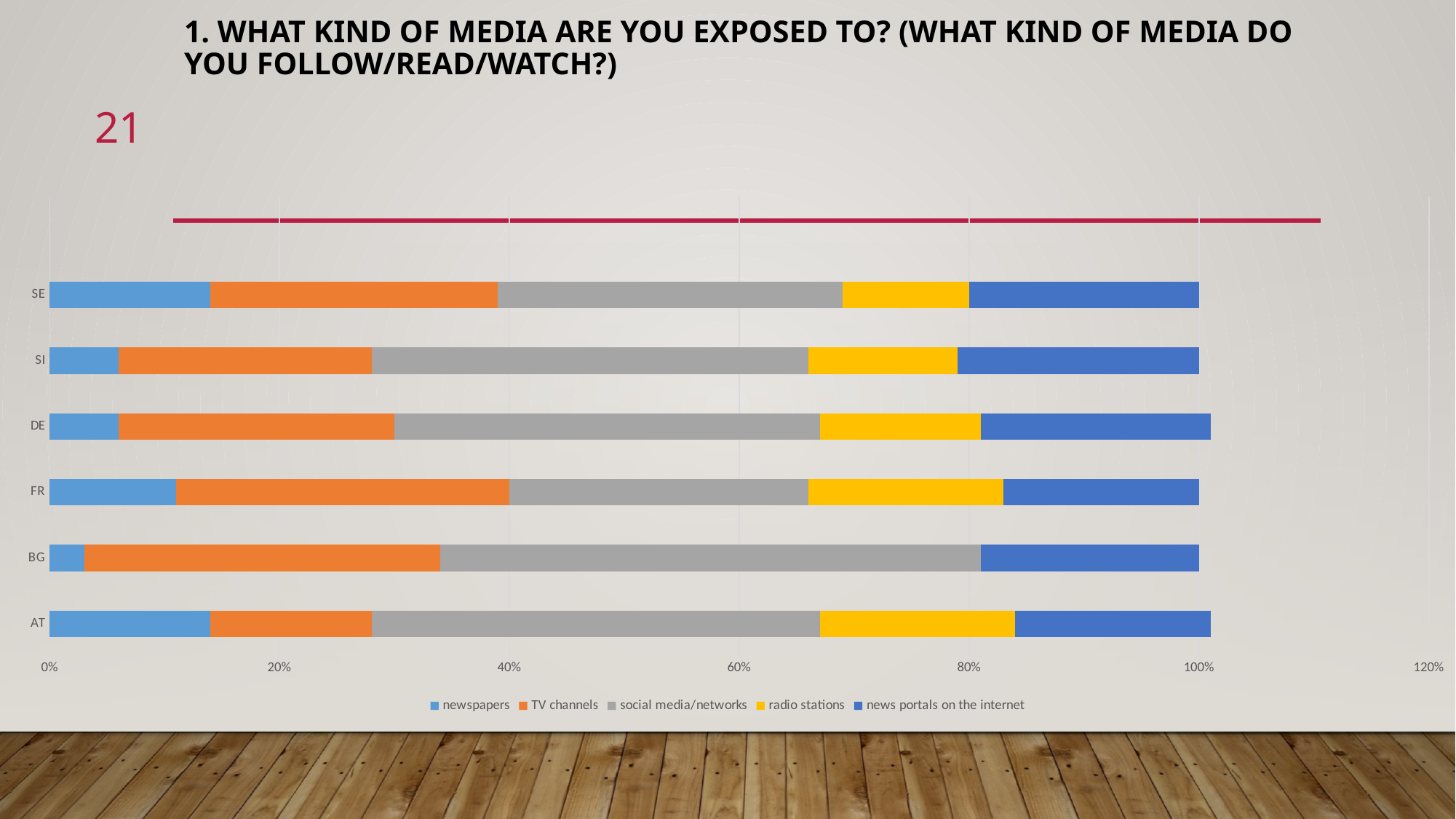
Is the social media/networks value for BG greater or less than 40%? greater Which is larger, the TV channels share for BG or for AT? BG What kind of chart is shown on the slide? Stacked bar chart Which is larger, the newspapers share for SE or for BG? SE Is the newspapers value for SE greater or less than 20%? less Which country has the smallest newspapers share? BG Is the TV channels value for BG greater or less than 20%? greater Which series is shown in orange in the legend? TV channels How many countries are shown on the chart? 6 How many series does the legend list? 5 Which series is listed last in the legend? news portals on the internet Which country has the largest social media/networks share? BG